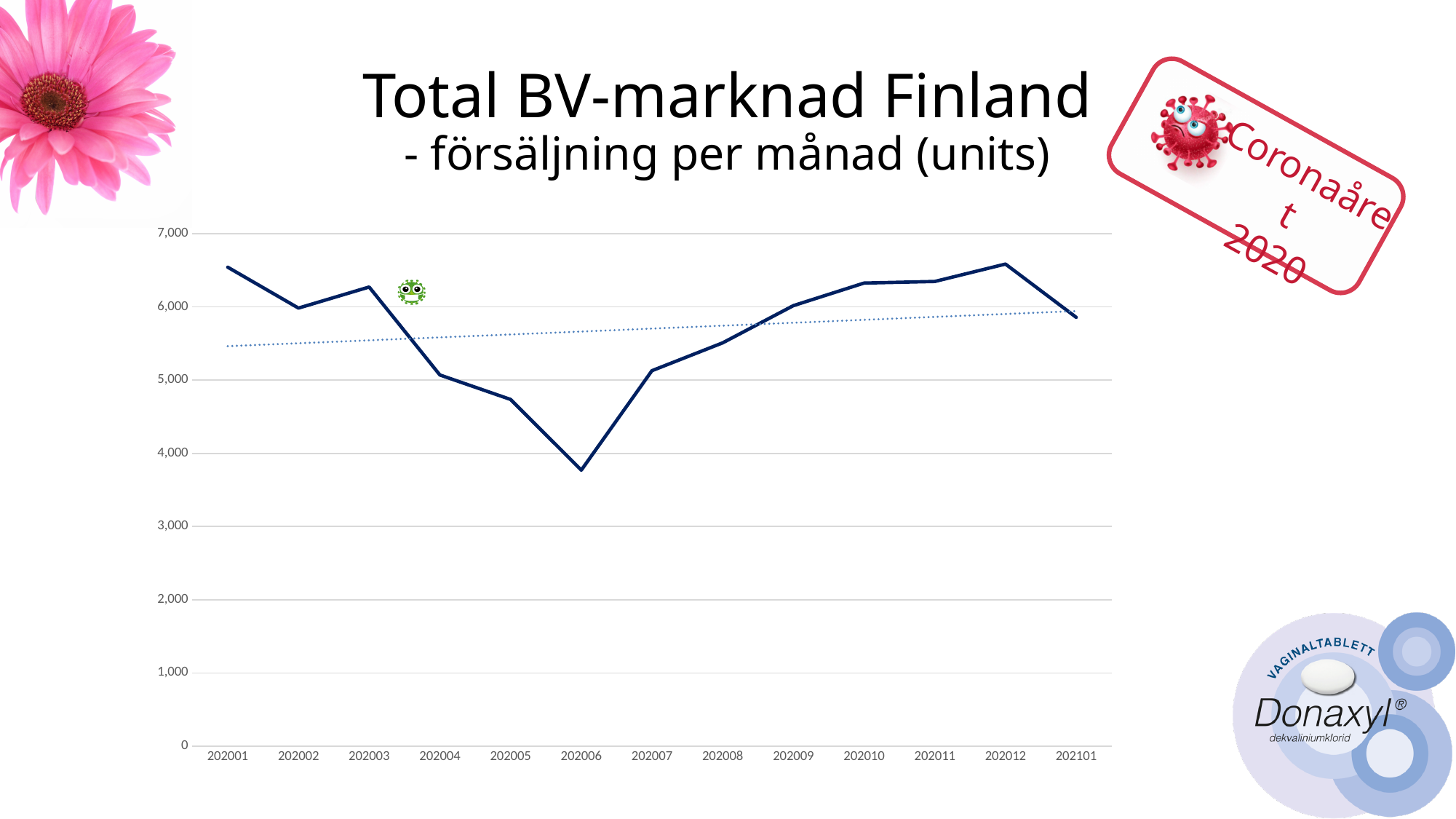
Is the value for 202005 greater or less than 5,000? less Which month has the lowest value on the chart? 202006 Which is larger, the value for 202003 or the value for 202004? 202003 Do the values rise or fall from 202006 to 202012? rise What is the title of the chart on the slide? Total BV-marknad Finland - försäljning per månad (units) Is the value for 202006 greater or less than 4,000? less Do the values rise or fall from 202003 to 202006? fall How many months (data points) are plotted along the x axis? 13 Is the value for 202101 greater or less than 6,000? less What kind of chart is shown on the slide? line chart